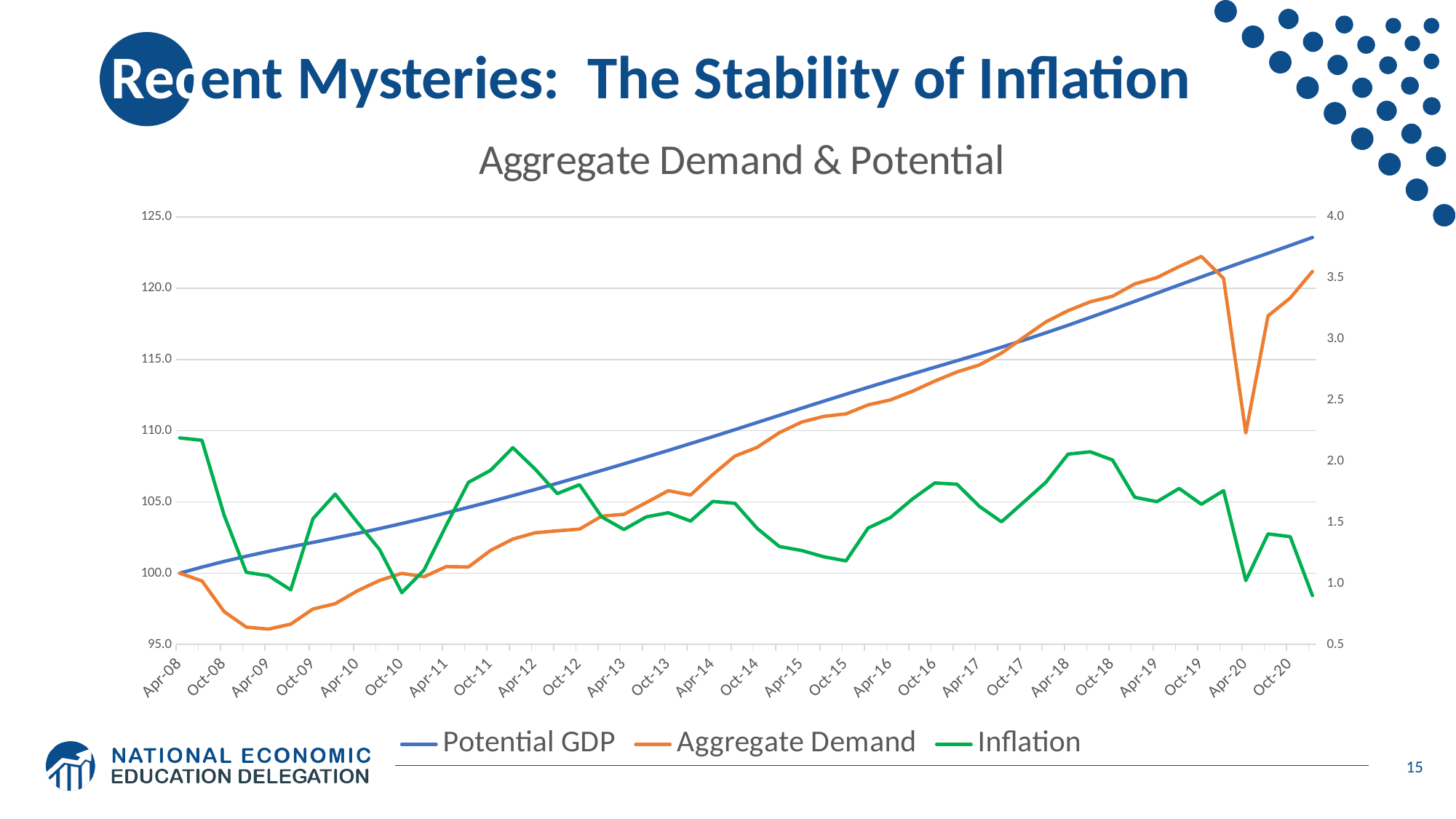
Is the value for Inflation at Apr-08 greater or less than 2.0 on the right axis? greater Does the Potential GDP line rise or fall from Apr-08 to Oct-20? rise Which is larger at Apr-20, Potential GDP or Aggregate Demand? Potential GDP How many series does the legend list? 3 Is the value for Aggregate Demand at Apr-20 greater or less than 115.0? less Is the value for Potential GDP at Oct-20 greater or less than 120.0? greater What is the value of Potential GDP at Apr-08? 100.0 What is the title of the chart? Aggregate Demand & Potential What colour is the Inflation line? green What is the value of Aggregate Demand at Apr-08? 100.0 What kind of chart is shown on the slide? line chart